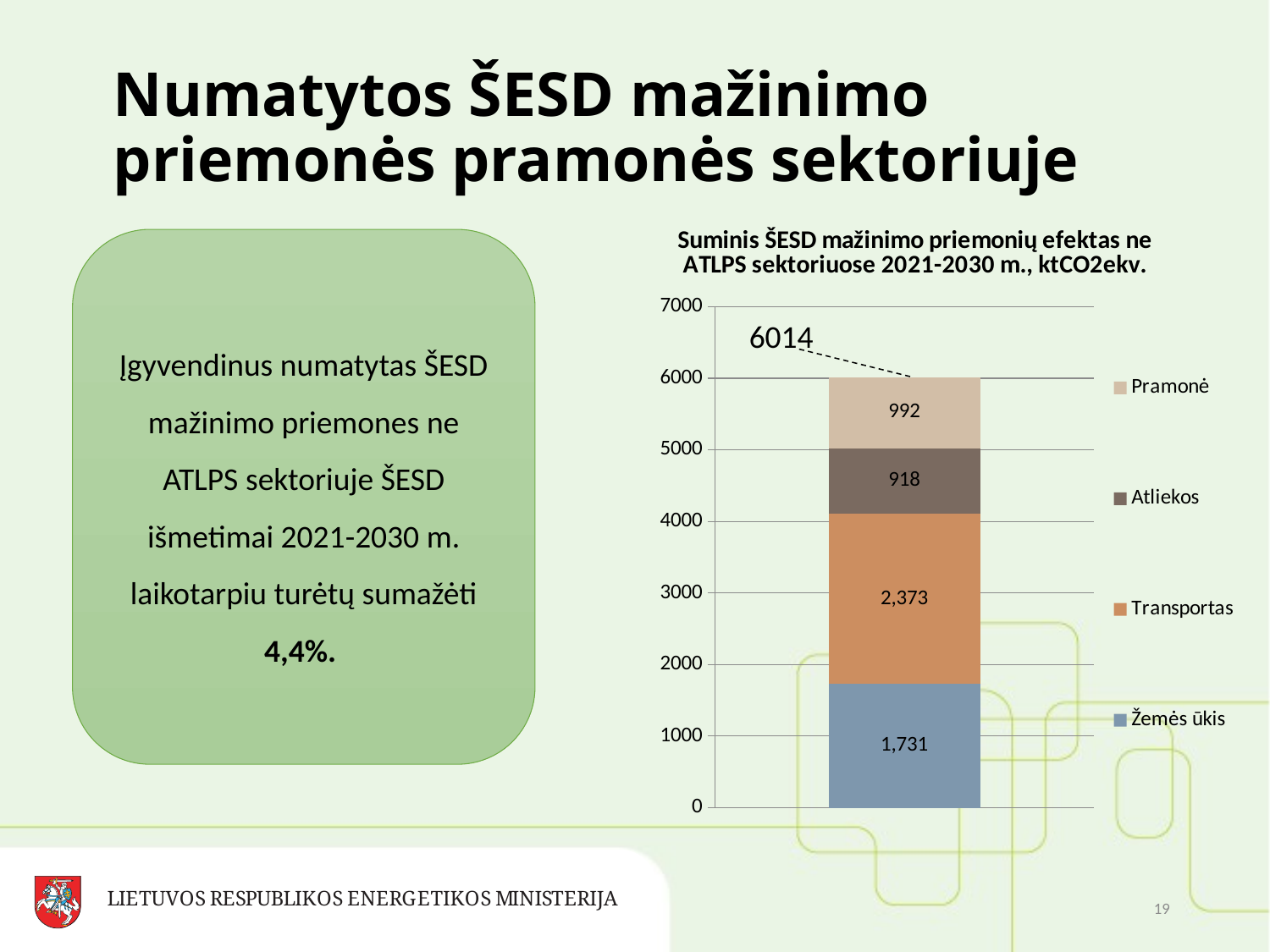
What is the value of the Atliekos segment in the stacked bar? 918 What is the value of the Žemės ūkis segment in the stacked bar? 1,731 Which is larger, the Pramonė segment or the Atliekos segment? Pramonė What is the value of the Transportas segment in the stacked bar? 2,373 What is the value of the Pramonė segment in the stacked bar? 992 Which sector contributes the smallest segment of the stacked bar? Atliekos How many series does the legend list? 4 What kind of chart is shown on the slide? Stacked bar chart Which sector contributes the largest segment of the stacked bar? Transportas What unit is given in the chart title? ktCO2ekv. What is the total of the stacked bar as labelled on the chart? 6014 What is the difference between the Transportas and Žemės ūkis segments? 642